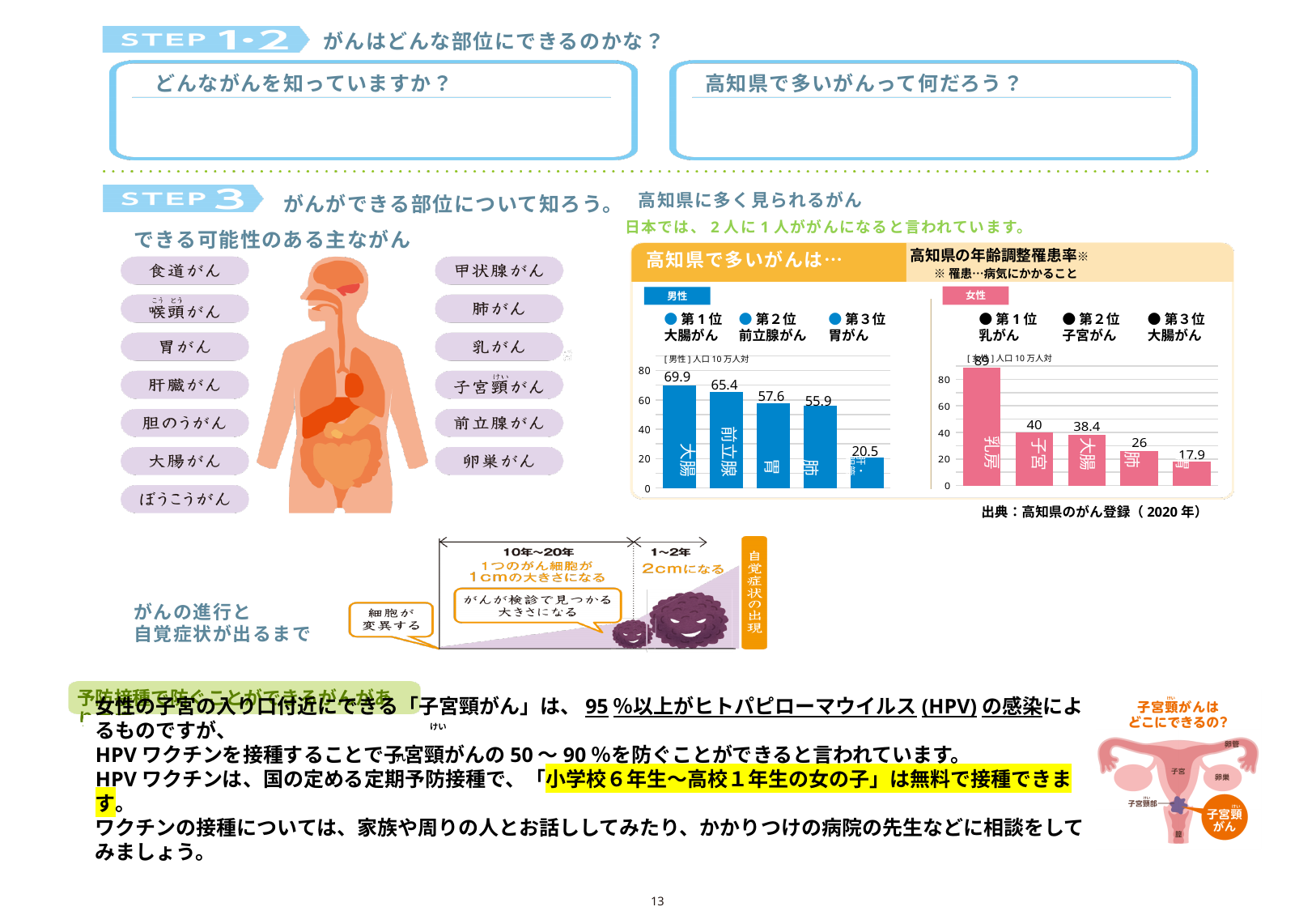
How many bars are shown in the female (女性) chart? 5 In the female (女性) chart, which is larger, the value for 大腸 or the value for 肺? 大腸 In the male (男性) chart, which category has the highest value? 大腸 In the female (女性) chart, which category has the lowest value? 胃 In the female (女性) chart, what is the value for 子宮? 40 In the male (男性) chart, what is the value for 肺? 55.9 In the male (男性) chart, what is the value for 大腸? 69.9 In the male (男性) chart, what is the difference between the values for 大腸 and 胃? 12.3 In the male (男性) chart, what is the value for 前立腺? 65.4 In the female (女性) chart, is the value for 乳房 greater or less than 80? greater What kind of chart is used to show the male (男性) cancer incidence rates? bar chart In the female (女性) chart, what is the value for 胃? 17.9